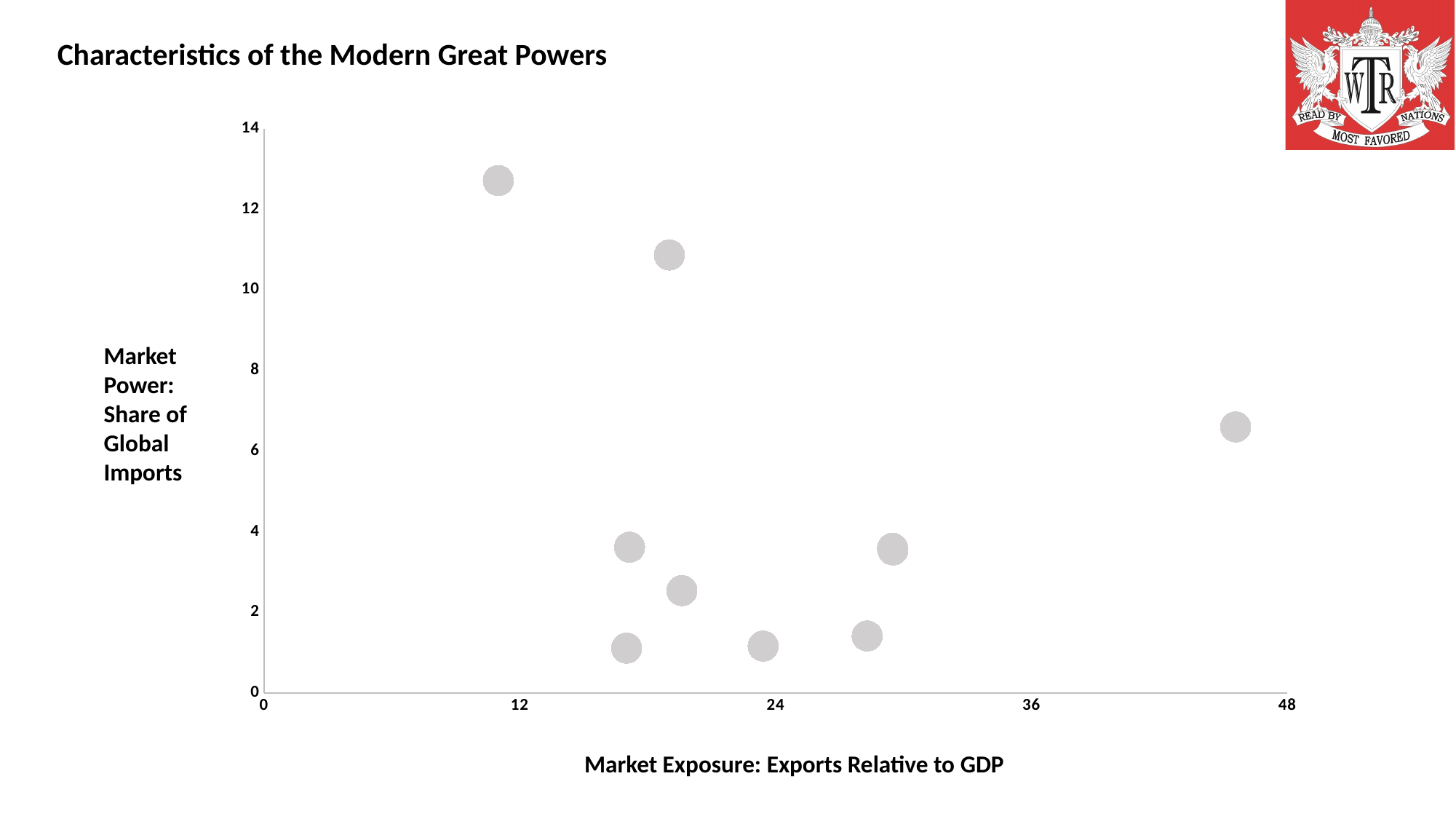
Is the Market Exposure value of the second-highest point less or greater than 24? less Is the Market Exposure value of the rightmost point greater or less than 36? greater What is the label of the horizontal axis? Market Exposure: Exports Relative to GDP Is the Market Power value of the rightmost point greater or less than 8? less How many points have a Market Power value above 10? 2 What is the title of the chart on the slide? Characteristics of the Modern Great Powers What kind of chart is shown on the slide? scatter chart